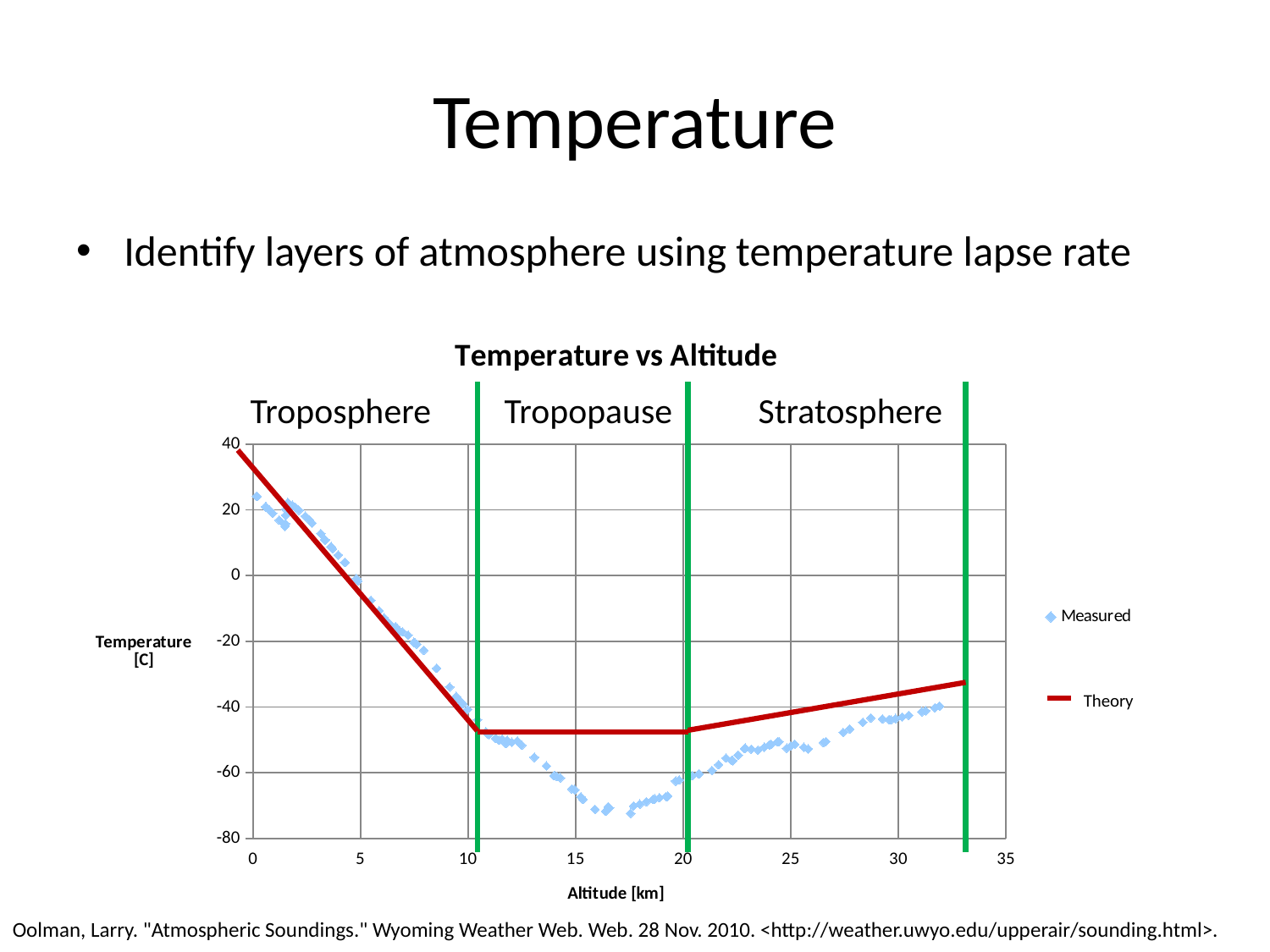
Does the Theory line rise or fall as altitude increases from 20 to 33 km? rise Is the Theory value at an altitude of 15 km greater or less than -40? less In which labeled atmospheric layer does the Measured series reach its lowest temperature? Tropopause Is the Measured value at an altitude of 17 km greater or less than -60? less How many series does the legend list? 2 Is the Theory value at an altitude of 0 km greater or less than 20? greater What kind of chart is shown on the slide? scatter chart At an altitude of 15 km, which series has the higher temperature, Measured or Theory? Theory What is the title of the chart? Temperature vs Altitude Does the Theory line rise or fall as altitude increases from 0 to 10 km? fall What are the two series named in the legend? Measured and Theory